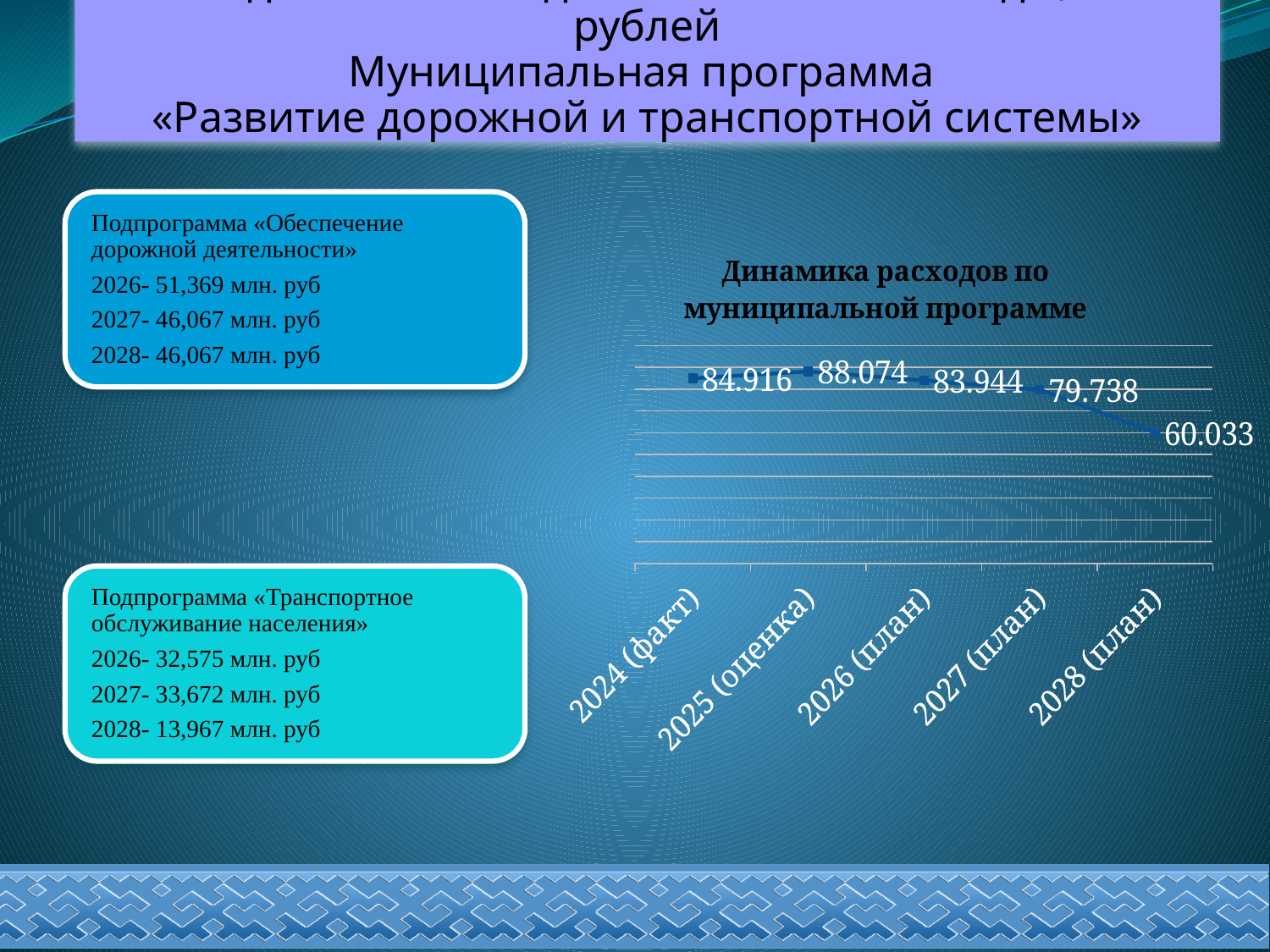
What is the title of the chart? Динамика расходов по муниципальной программе What is the value for 2028 (план)? 60.033 Do the values rise or fall from 2025 (оценка) to 2028 (план)? fall Which category has the highest value? 2025 (оценка) Which category has the lowest value? 2028 (план) How many data points are plotted on the chart? 5 What is the value for 2024 (факт)? 84.916 Which is larger, the value for 2024 (факт) or the value for 2026 (план)? 2024 (факт) What is the value for 2025 (оценка)? 88.074 What is the value for 2026 (план)? 83.944 What is the difference between the values for 2027 (план) and 2028 (план)? 19.705 What type of chart is shown on the slide? line chart